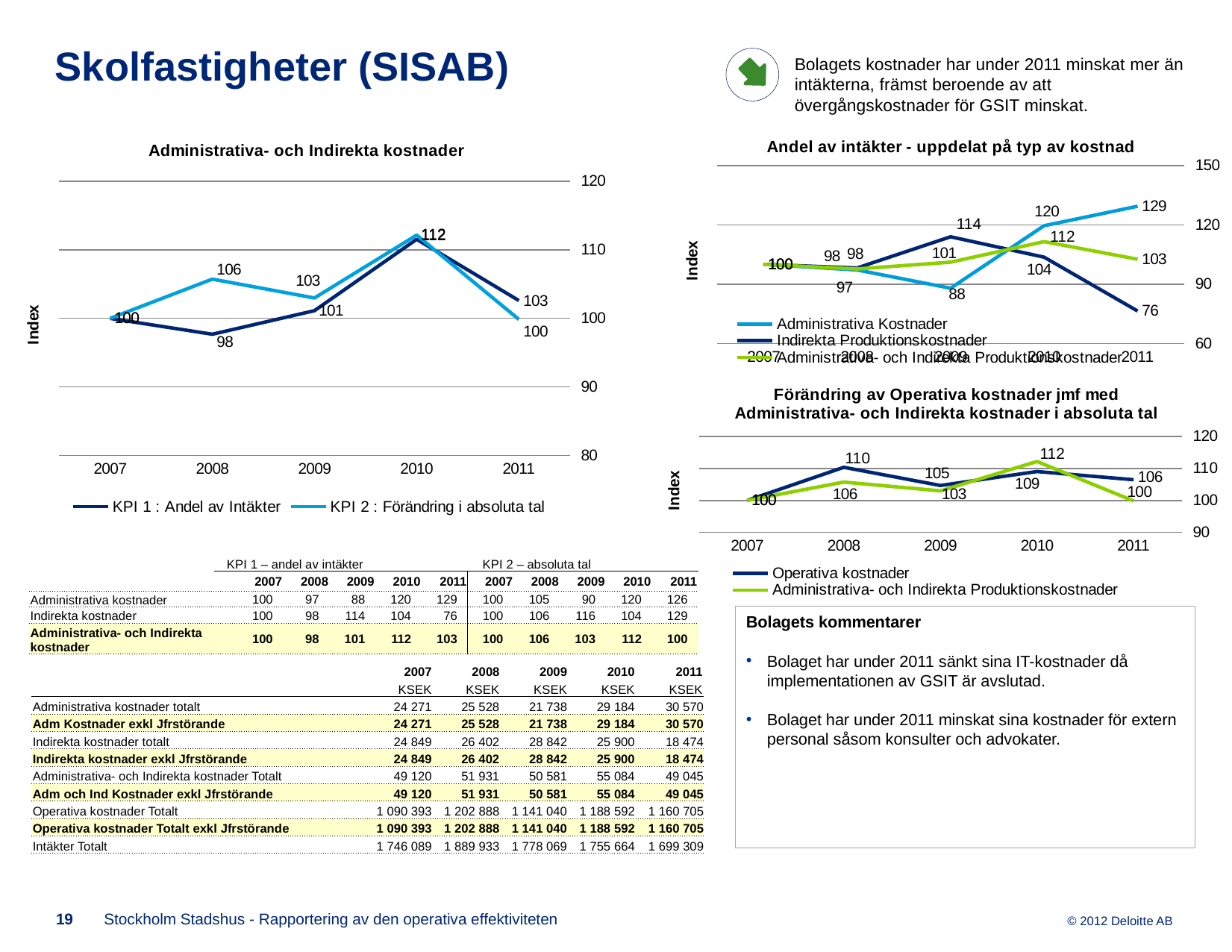
In the chart titled 'Andel av intäkter - uppdelat på typ av kostnad', what is the value of Administrativa Kostnader in 2011? 129 In the chart titled 'Administrativa- och Indirekta kostnader', what is the value of KPI 1 : Andel av Intäkter in 2010? 112 In the chart titled 'Administrativa- och Indirekta kostnader', in which year is KPI 1 : Andel av Intäkter lowest? 2008 In the chart titled 'Administrativa- och Indirekta kostnader', what kind of chart is it? Line chart In the chart titled 'Andel av intäkter - uppdelat på typ av kostnad', what is the value of Indirekta Produktionskostnader in 2011? 76 In the chart titled 'Andel av intäkter - uppdelat på typ av kostnad', what is the difference between Administrativa Kostnader and Indirekta Produktionskostnader in 2011? 53 In the chart titled 'Andel av intäkter - uppdelat på typ av kostnad', how many years are shown on the x axis? 5 In the chart titled 'Administrativa- och Indirekta kostnader', what is the value of KPI 2 : Förändring i absoluta tal in 2008? 106 In the chart titled 'Andel av intäkter - uppdelat på typ av kostnad', which series has the highest value in 2009? Indirekta Produktionskostnader In the chart titled 'Administrativa- och Indirekta kostnader', how many series does the legend list? 2 In the chart titled 'Förändring av Operativa kostnader jmf med Administrativa- och Indirekta kostnader i absoluta tal', which series is higher in 2010? Administrativa- och Indirekta Produktionskostnader In the chart titled 'Förändring av Operativa kostnader jmf med Administrativa- och Indirekta kostnader i absoluta tal', what is the value of Operativa kostnader in 2008? 110